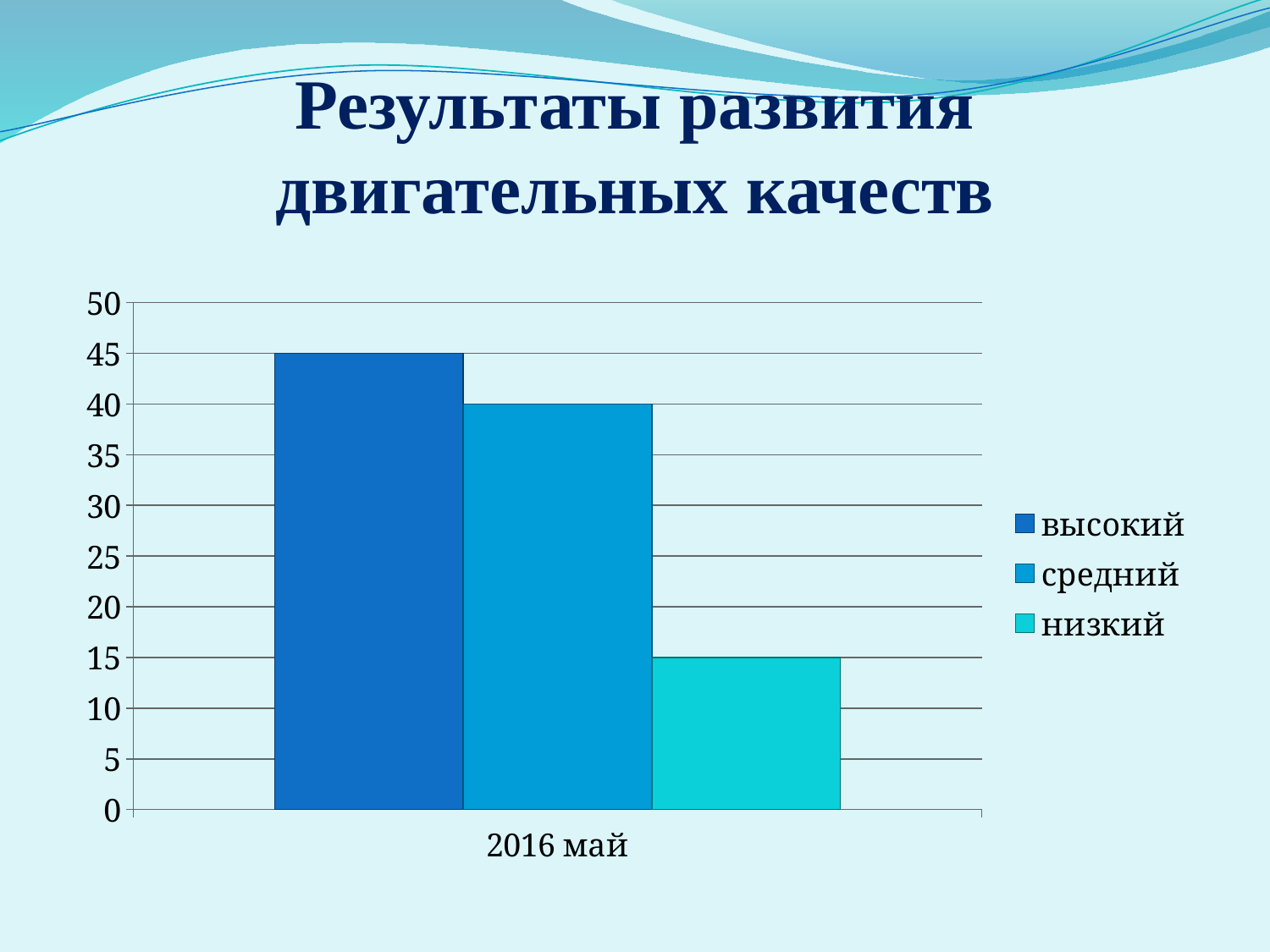
What is the difference between the values for высокий and средний? 5 Is the value for низкий greater or less than 20? less What is the value for средний in 2016 май? 40 Which series has the lowest value? низкий What kind of chart is shown on the slide? bar chart What is the difference between the values for высокий and низкий? 30 How many series does the legend list? 3 What is the value for низкий in 2016 май? 15 What is the value for высокий in 2016 май? 45 Which is larger, the value for средний or the value for низкий? средний What is the title of the slide? Результаты развития двигательных качеств Which series has the highest value? высокий